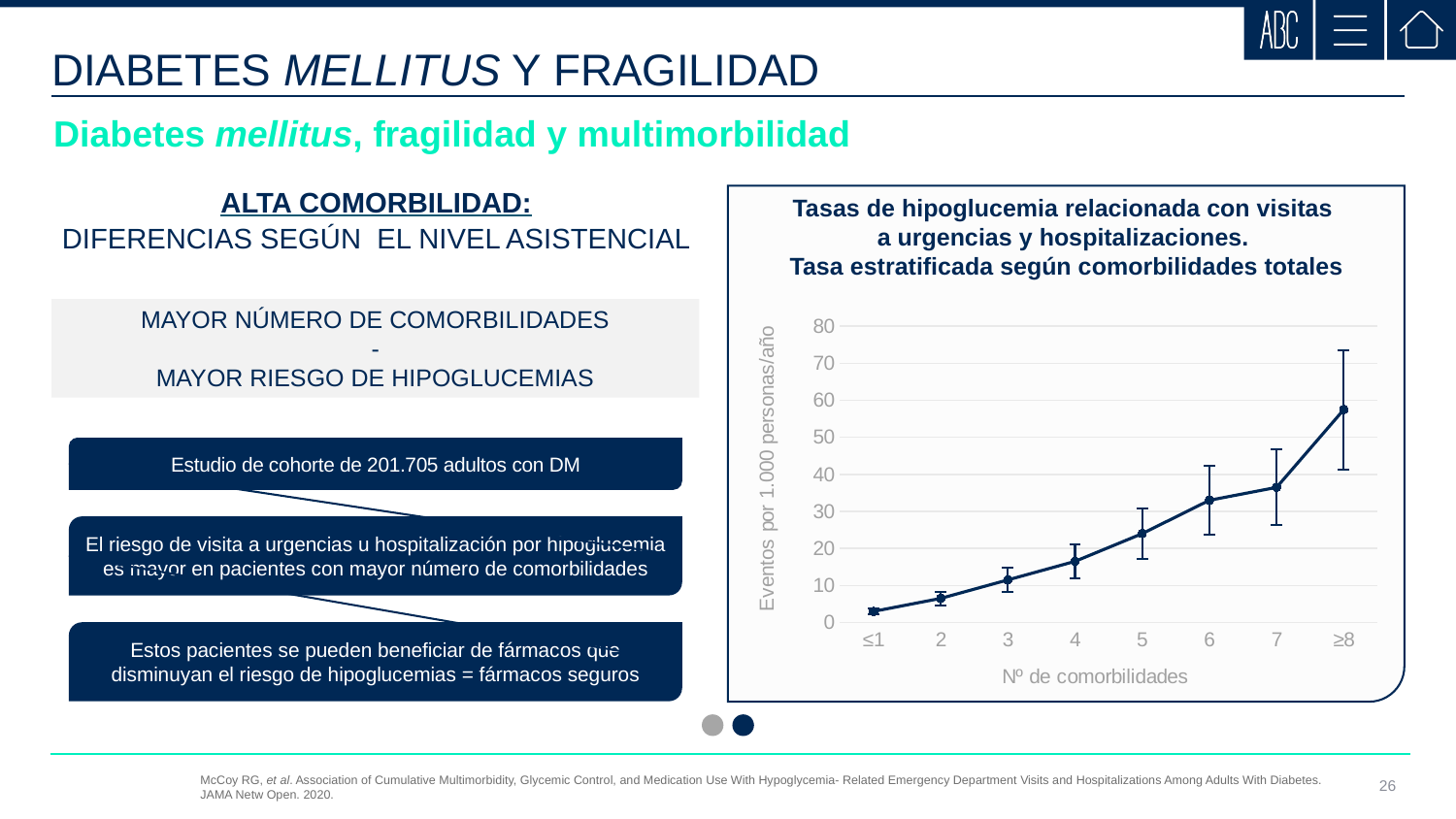
Which comorbidity category has the highest rate of events per 1,000 persons/year? ≥8 Do the event rates rise or fall as the number of comorbidities increases along the x axis? rise What is the label of the x axis of the chart? Nº de comorbilidades How many comorbidity categories are plotted along the x axis? 8 Which has a higher event rate, 4 comorbidities or 6 comorbidities? 6 comorbidities What is the label of the y axis of the chart? Eventos por 1.000 personas/año Is the value for 6 comorbidities greater or less than 30? greater Is the value for ≥8 comorbidities greater or less than 50? greater What kind of chart is shown on the slide? line chart Is the value for 5 comorbidities greater or less than 30? less Which comorbidity category has the lowest rate of events per 1,000 persons/year? ≤1